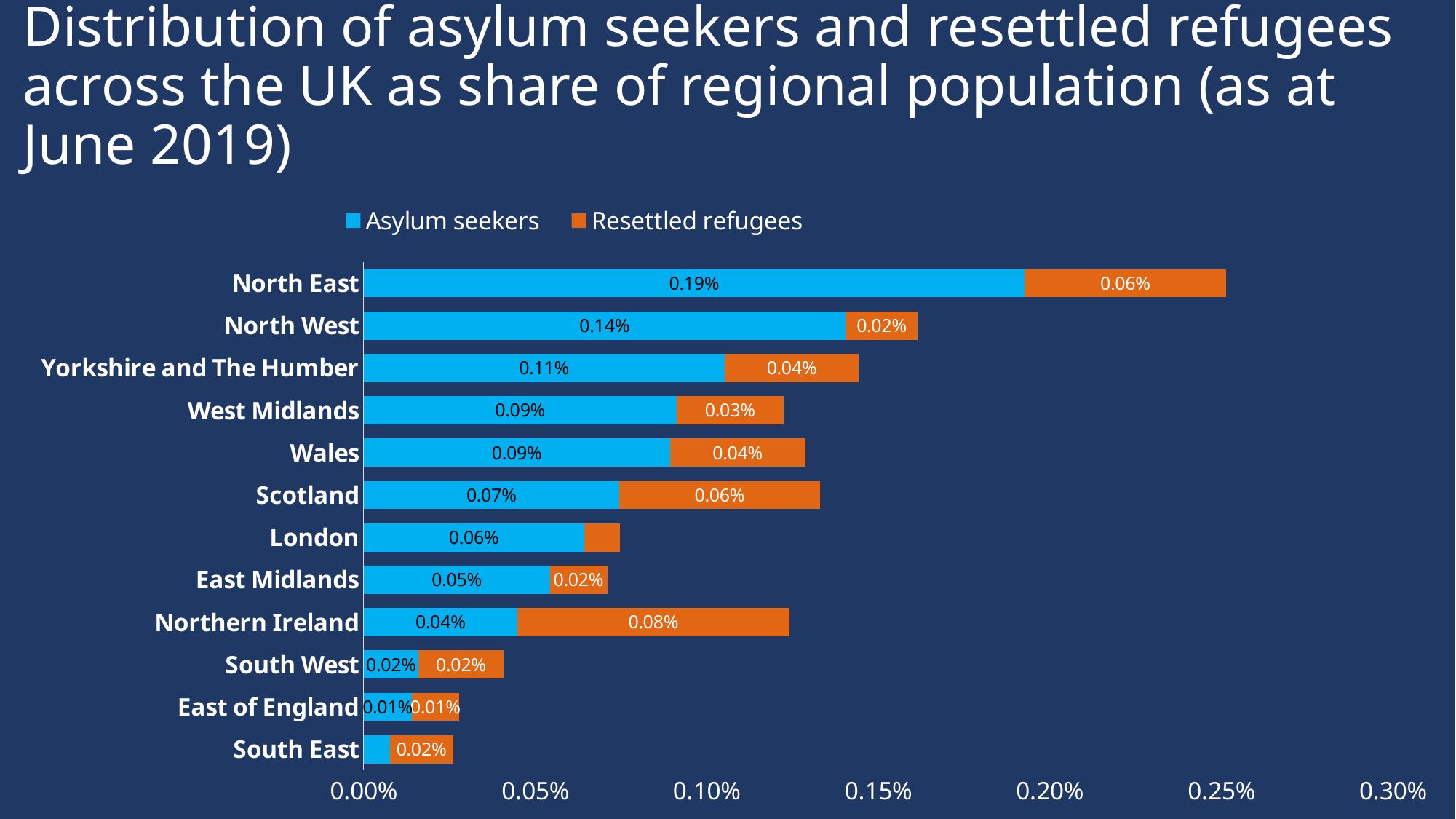
Which is larger: the Asylum seekers value for Scotland or for Northern Ireland? Scotland How many series does the legend list? 2 What kind of chart is shown on the slide? Stacked bar chart What is the Asylum seekers value for North East? 0.19% How many regions are shown on the chart? 12 Which region has the highest Asylum seekers value? North East What is the total of the stacked bar for North East? 0.25% What is the difference between the Asylum seekers and Resettled refugees values for North East? 0.13% Is the total stacked bar for North East greater or less than 0.20%? greater Which region has the highest Resettled refugees value? Northern Ireland What is the Resettled refugees value for Northern Ireland? 0.08% Which colour represents Resettled refugees in the legend? Orange